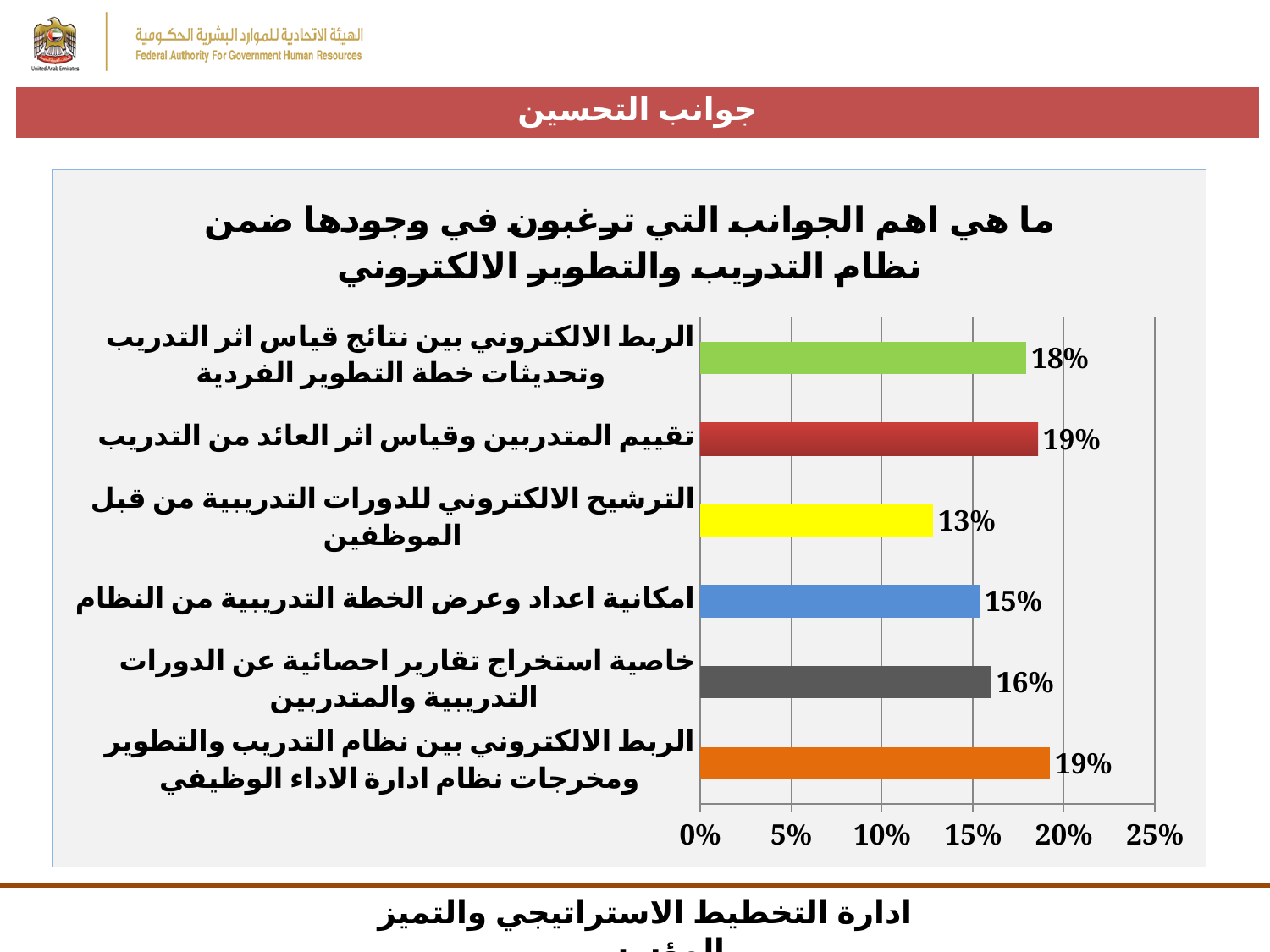
How many categories are plotted in the chart? 6 Which is larger: the value for "الربط الالكتروني بين نتائج قياس اثر التدريب وتحديثات خطة التطوير الفردية" or the value for "امكانية اعداد وعرض الخطة التدريبية من النظام"? الربط الالكتروني بين نتائج قياس اثر التدريب وتحديثات خطة التطوير الفردية What colour is the bar for "الترشيح الالكتروني للدورات التدريبية من قبل الموظفين"? yellow What is the difference between the value for "تقييم المتدربين وقياس اثر العائد من التدريب" and the value for "الترشيح الالكتروني للدورات التدريبية من قبل الموظفين"? 6% What is the maximum value shown on the x axis of the chart? 25% What is the value for "تقييم المتدربين وقياس اثر العائد من التدريب"? 19% What is the value for "الترشيح الالكتروني للدورات التدريبية من قبل الموظفين"? 13% What is the value for "امكانية اعداد وعرض الخطة التدريبية من النظام"? 15% What type of chart is shown on the slide? bar chart What is the value for "الربط الالكتروني بين نتائج قياس اثر التدريب وتحديثات خطة التطوير الفردية"? 18% What is the value for "خاصية استخراج تقارير احصائية عن الدورات التدريبية والمتدربين"? 16% Which category has the lowest value? الترشيح الالكتروني للدورات التدريبية من قبل الموظفين